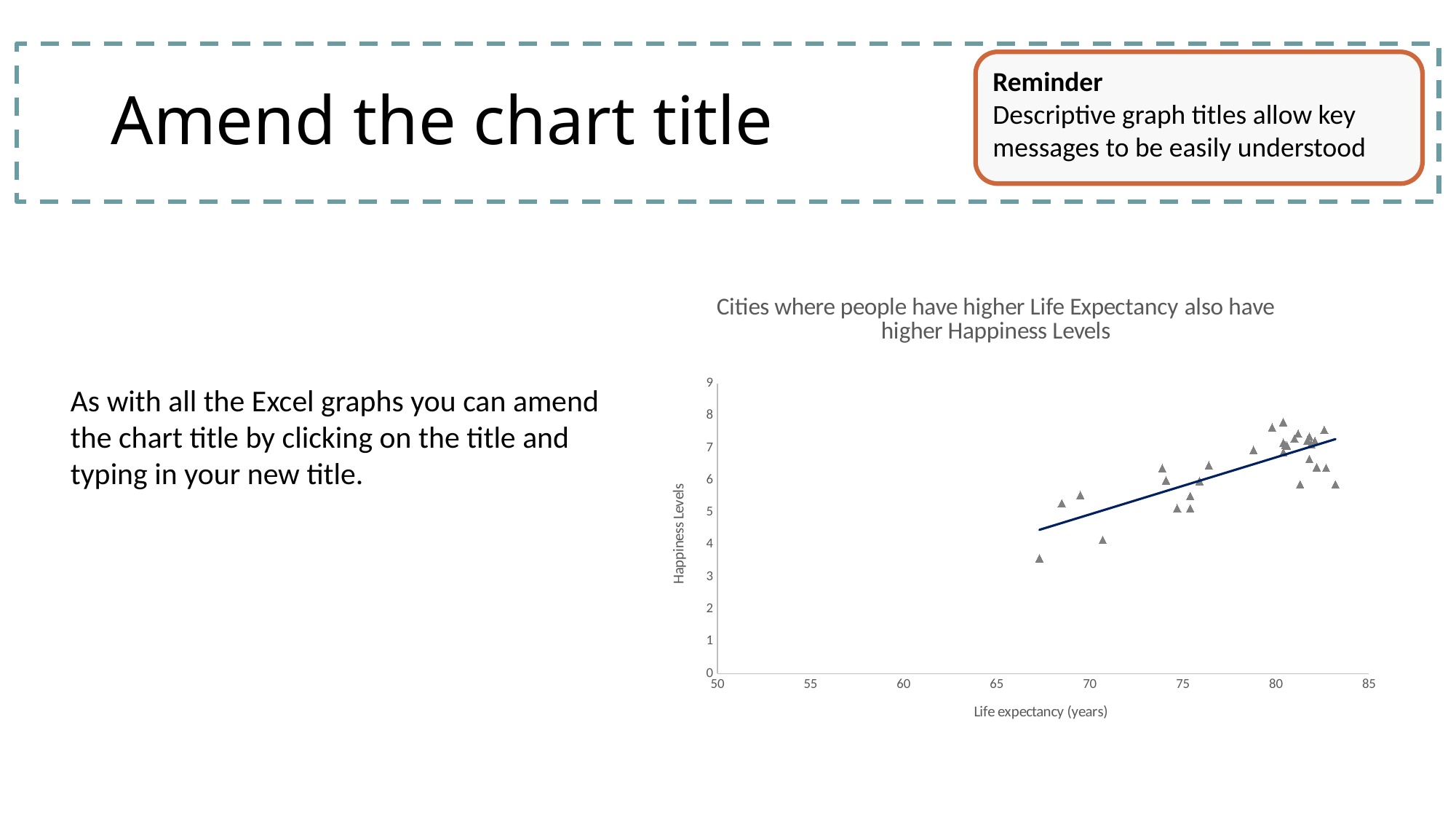
Is the highest happiness level plotted on the chart greater or less than 7? greater Is the life expectancy of every plotted point greater or less than 65 years? greater Is the life expectancy of every plotted point greater or less than 85 years? less Does the trend line on the chart slope upward or downward? Upward As life expectancy increases along the x axis, do happiness levels generally rise or fall? Rise What is the label of the x axis of the chart? Life expectancy (years) What kind of chart is shown on the slide? Scatter chart What is the title of the chart? Cities where people have higher Life Expectancy also have higher Happiness Levels